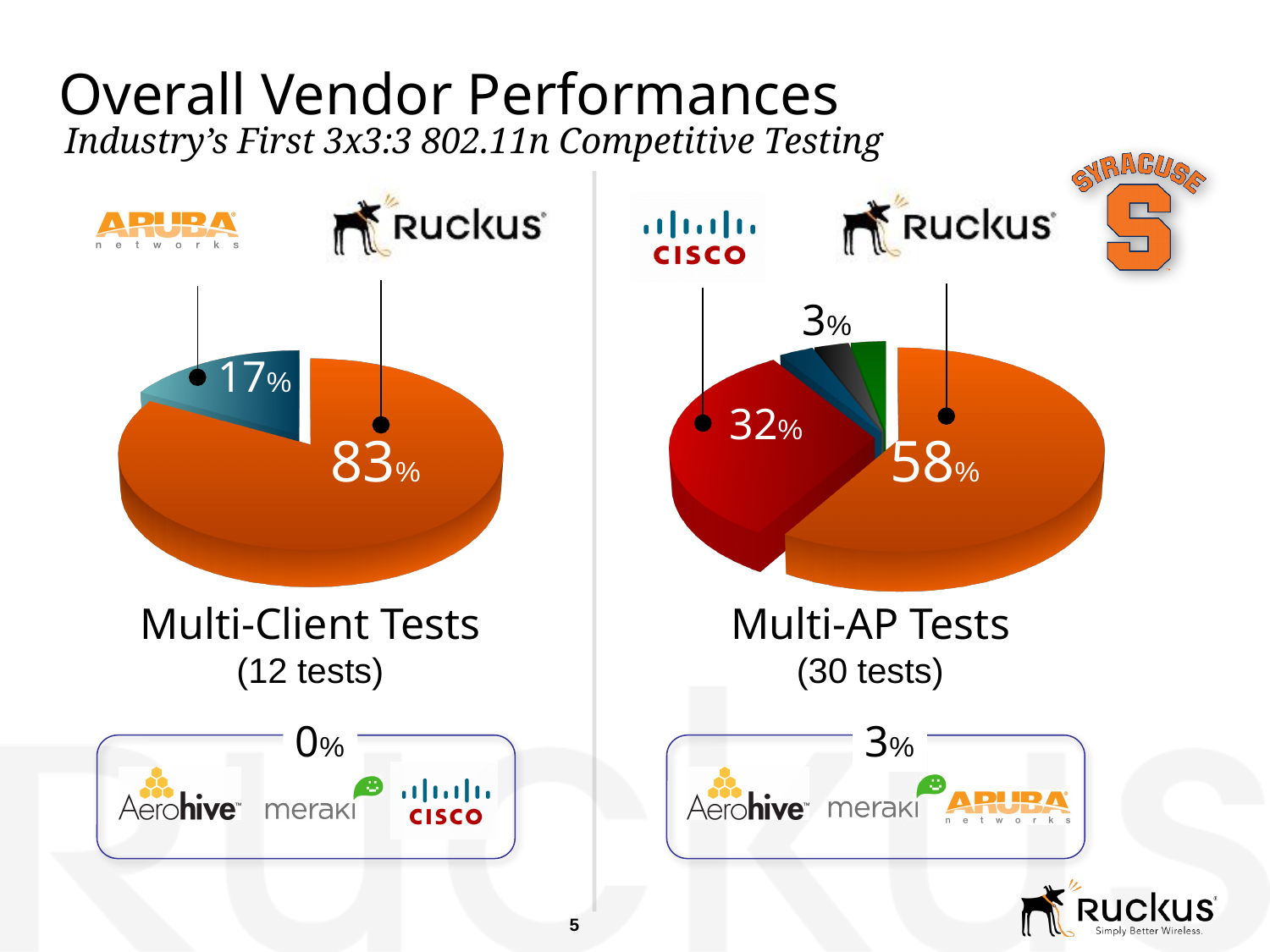
In the Multi-Client Tests chart, what is the difference between the Ruckus share and the Aruba share? 66% In the Multi-AP Tests chart, what share does Cisco have? 32% In the Multi-AP Tests chart, which vendor has the largest share? Ruckus In the Multi-Client Tests chart, what share does Aruba Networks have? 17% How many tests does the Multi-AP Tests chart cover? 30 tests In the Multi-Client Tests chart, what share does Ruckus have? 83% In the Multi-AP Tests chart, what is the difference between the Ruckus share and the Cisco share? 26% In the Multi-AP Tests chart, is the Cisco share larger or smaller than the Ruckus share? smaller In the Multi-Client Tests chart, which vendor has the largest share? Ruckus In the Multi-Client Tests chart, what share do Aerohive, Meraki and Cisco each have? 0% What kind of chart is used for the Multi-Client Tests? pie chart In the Multi-AP Tests chart, what share does Ruckus have? 58%